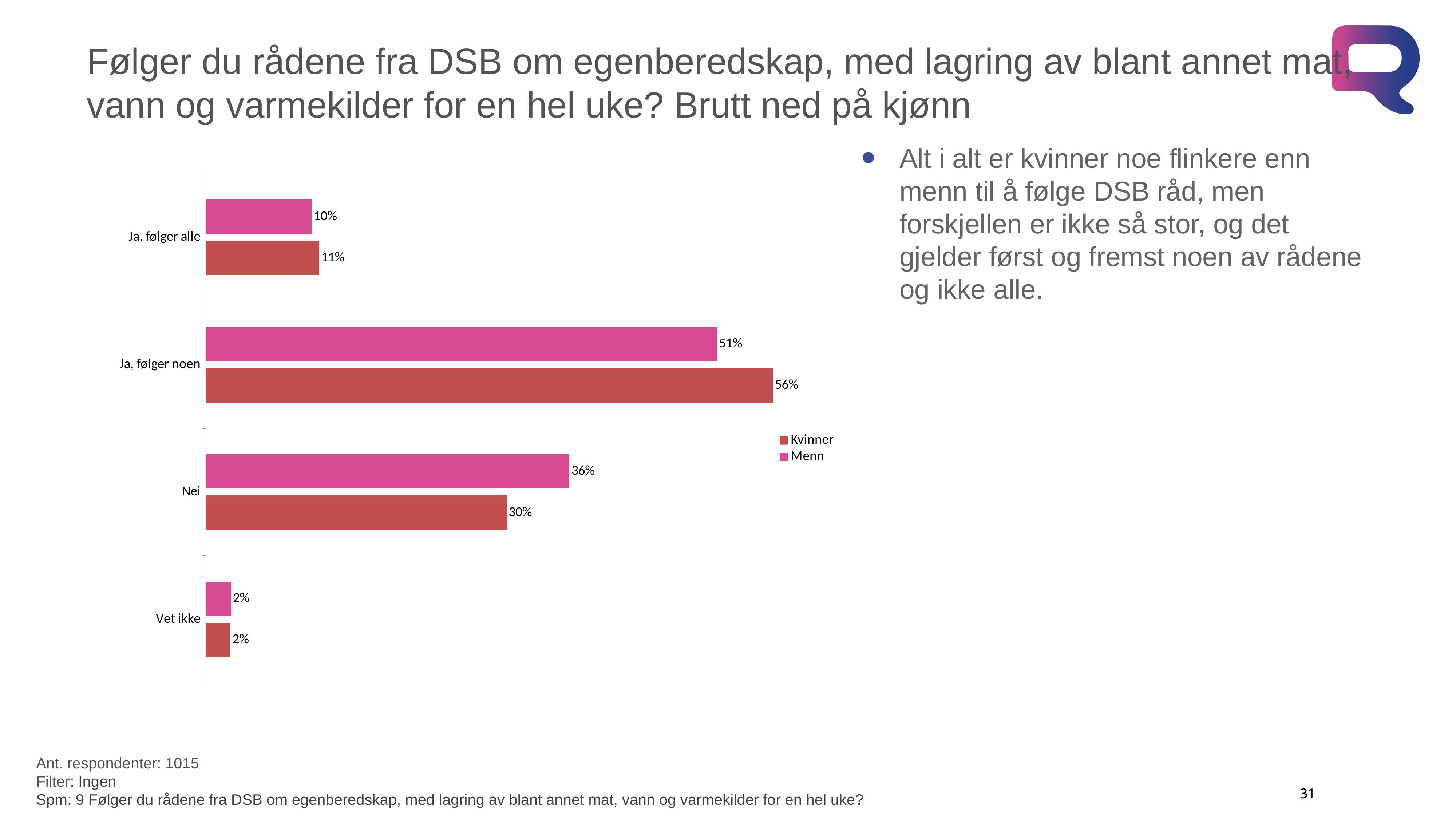
Which category has the highest value for Kvinner? Ja, følger noen Which series has the larger value in the "Nei" category, Kvinner or Menn? Menn What is the difference between Menn and Kvinner in the "Nei" category? 6% What is the value for Menn in the "Nei" category? 36% What is the difference between Kvinner and Menn in the "Ja, følger noen" category? 5% What is the value for Menn in the "Ja, følger alle" category? 10% What is the value for Kvinner in the "Ja, følger noen" category? 56% How many series does the legend list? 2 What kind of chart is shown on the slide? Bar chart Which colour represents the Menn series in the chart? Pink Which category has the lowest value for Menn? Vet ikke How many categories are shown on the chart? 4